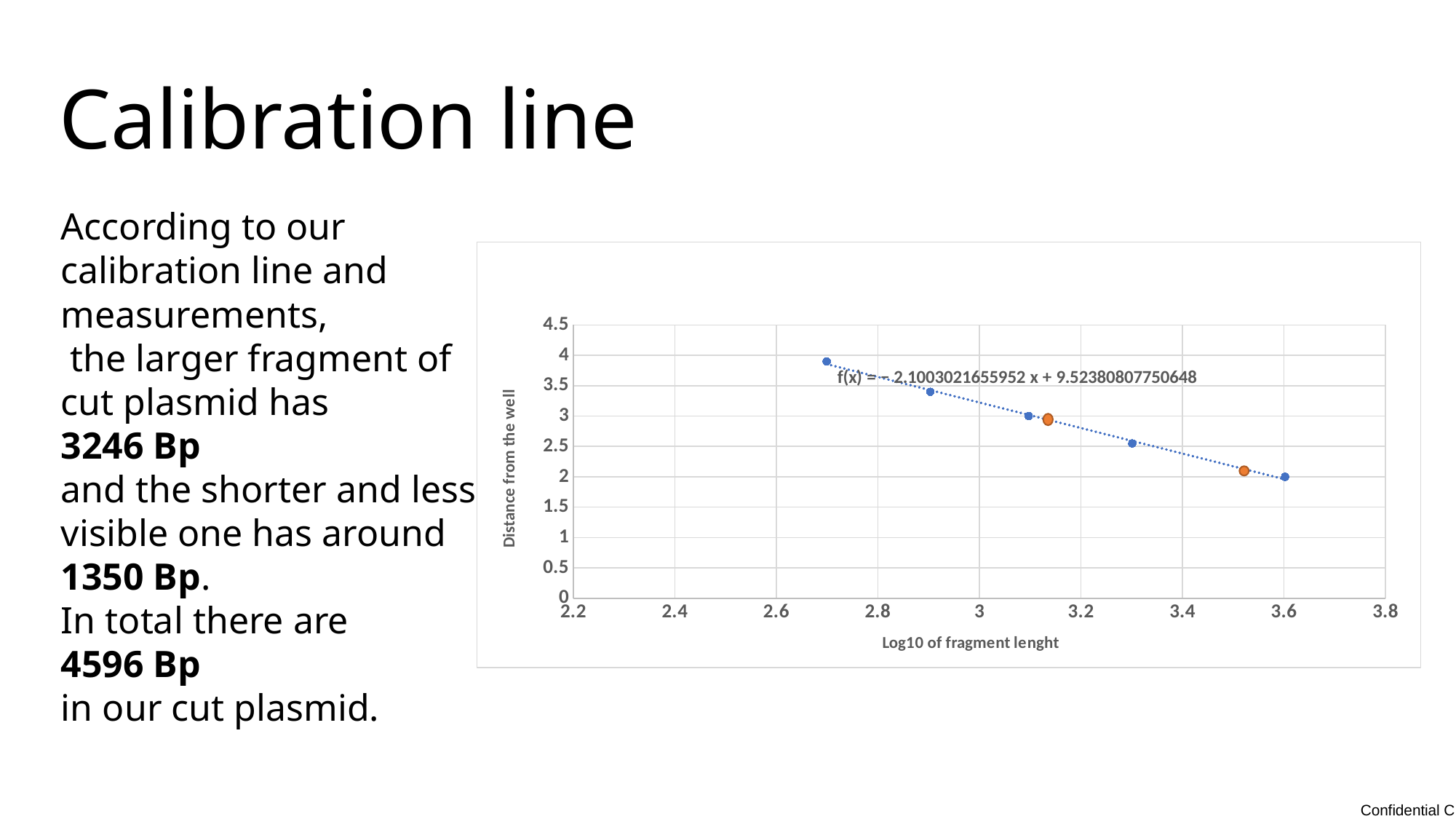
Is the distance from the well for the blue point at Log10 of fragment length 2.7 greater or less than 3.5? greater What is the highest tick value shown on the y axis of the chart? 4.5 How many orange data points are plotted on the chart? 2 Is the distance from the well for the blue point at Log10 of fragment length 3.3 greater or less than 3? less Do the plotted values rise or fall as Log10 of fragment length increases? Fall What is the title of the x axis of the chart? Log10 of fragment lenght What kind of chart is shown on the slide? Scatter chart What is the trendline equation shown on the chart? f(x) = -2.1003021655952 x + 9.52380807750648 Is the distance from the well for the blue point at Log10 of fragment length 2.9 greater or less than 3? greater Which blue point has the highest distance from the well: the one at Log10 of fragment length 2.7 or the one at 3.6? The one at 2.7 How many blue data points are plotted on the chart? 5 What is the title of the y axis of the chart? Distance from the well